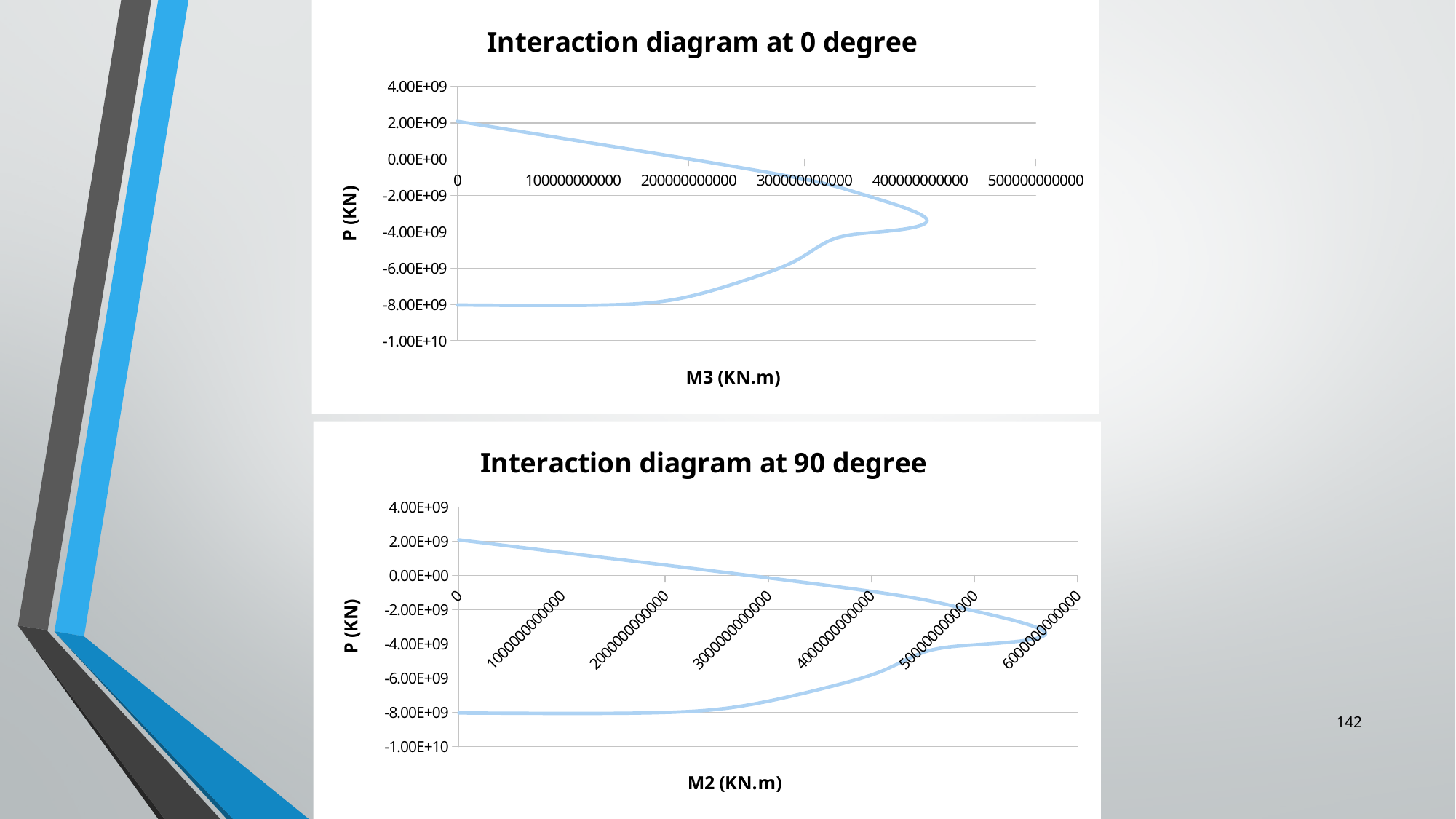
Which chart's curve reaches a larger maximum moment value on its x axis, the 0 degree chart or the 90 degree chart? Interaction diagram at 90 degree On the 'Interaction diagram at 0 degree' chart, is the largest M3 value reached by the curve greater or less than 500000000000? less On the 'Interaction diagram at 90 degree' chart, is the highest P value of the curve (at M2 = 0) greater or less than 0.00E+00? greater On the 'Interaction diagram at 0 degree' chart, as M3 increases from 0 along the upper branch of the curve, does P rise or fall? fall What kind of chart is the 'Interaction diagram at 0 degree'? line chart On the 'Interaction diagram at 90 degree' chart, what is the x-axis title? M2 (KN.m) On the 'Interaction diagram at 90 degree' chart, is the largest M2 value reached by the curve greater or less than 500000000000? greater On the 'Interaction diagram at 90 degree' chart, as M2 increases from 0 along the lower branch of the curve, does P rise or fall? rise What is the title of the bottom chart on the slide? Interaction diagram at 90 degree